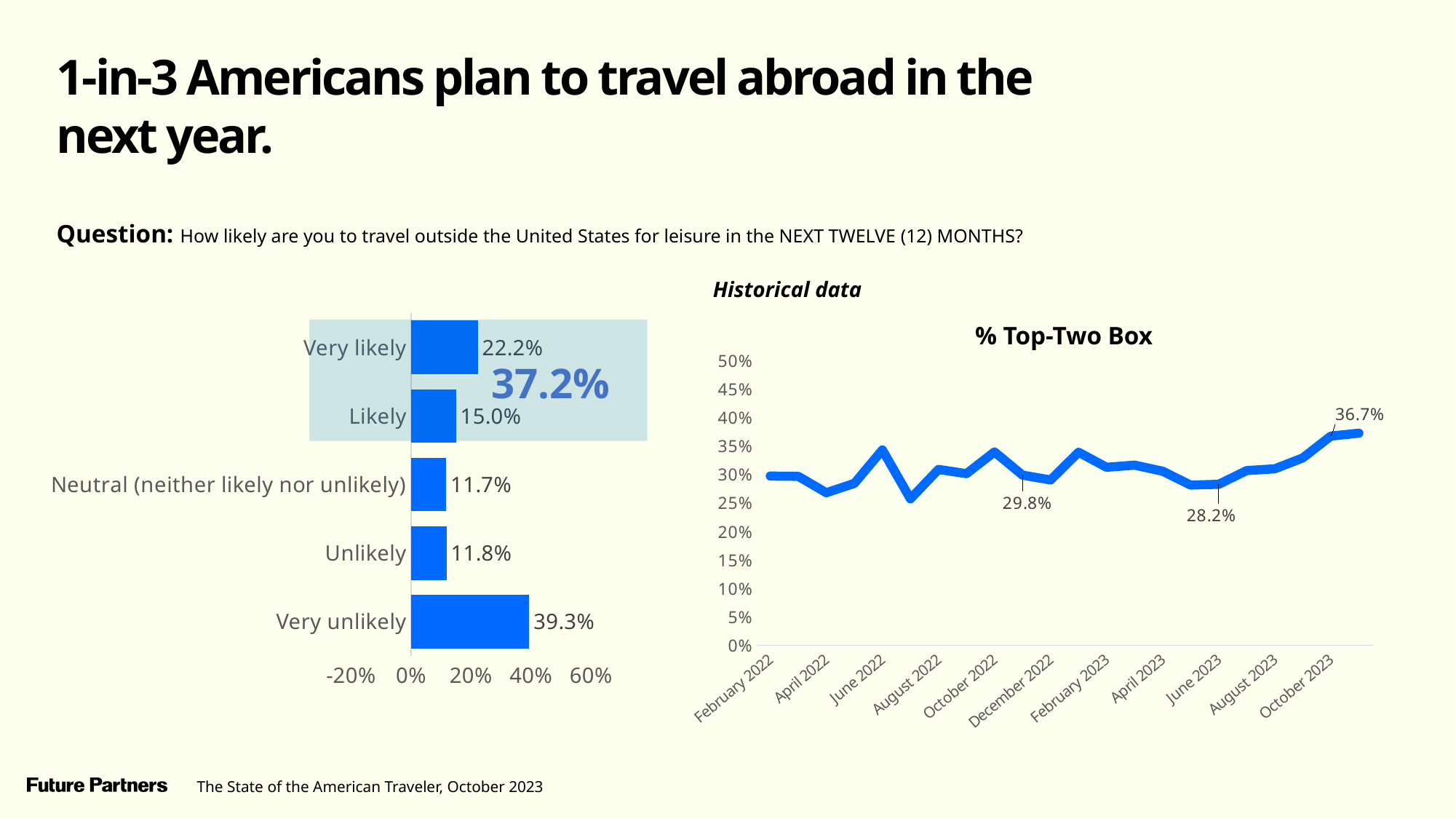
In the bar chart on the left, which response category has the highest value? Very unlikely In the '% Top-Two Box' line chart, is the value for February 2022 greater or less than 25%? greater In the bar chart on the left, what is the combined total of the 'Very likely' and 'Likely' categories as highlighted on the slide? 37.2% How many response categories are shown in the bar chart on the left? 5 What kind of chart is the chart on the left of the slide? Bar chart In the '% Top-Two Box' line chart, what is the value labeled for October 2023? 36.7% In the bar chart on the left, what percentage of respondents said they are 'Very likely' to travel outside the United States in the next twelve months? 22.2% In the bar chart on the left, which is larger: the value for 'Likely' or the value for 'Unlikely'? Likely In the '% Top-Two Box' line chart, what is the value labeled for June 2023? 28.2% In the '% Top-Two Box' line chart, what is the difference between the October 2023 value and the June 2023 value? 8.5% In the bar chart on the left, what is the difference between the 'Very unlikely' and 'Very likely' values? 17.1% In the bar chart on the left, what is the value for 'Very unlikely'? 39.3%